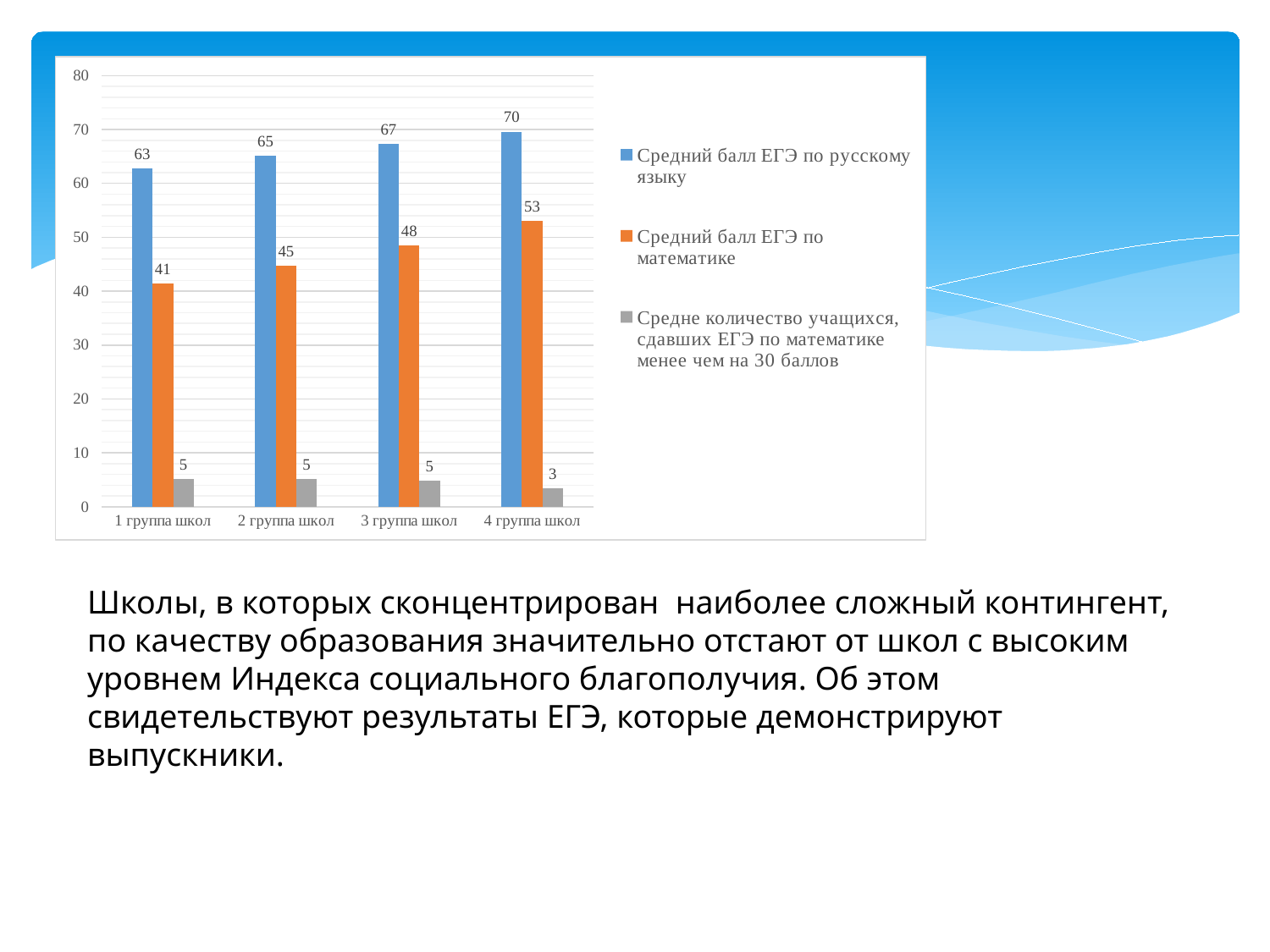
What is the difference between 'Средний балл ЕГЭ по русскому языку' and 'Средний балл ЕГЭ по математике' for '2 группа школ'? 20 Is the value of 'Средний балл ЕГЭ по русскому языку' for '3 группа школ' greater or less than 60? greater How many series does the legend list? 3 What kind of chart is shown on the slide? bar chart What is the value of 'Средний балл ЕГЭ по математике' for '3 группа школ'? 48 What is the value of 'Средний балл ЕГЭ по русскому языку' for '1 группа школ'? 63 How many groups of schools are shown on the x axis? 4 Which group of schools has the lowest value for 'Средний балл ЕГЭ по математике'? 1 группа школ Which is larger: 'Средний балл ЕГЭ по математике' for '4 группа школ' or for '2 группа школ'? 4 группа школ Does 'Средний балл ЕГЭ по математике' rise or fall from '1 группа школ' to '4 группа школ'? rise What is the value of 'Средне количество учащихся, сдавших ЕГЭ по математике менее чем на 30 баллов' for '4 группа школ'? 3 Which group of schools has the highest value for 'Средний балл ЕГЭ по русскому языку'? 4 группа школ